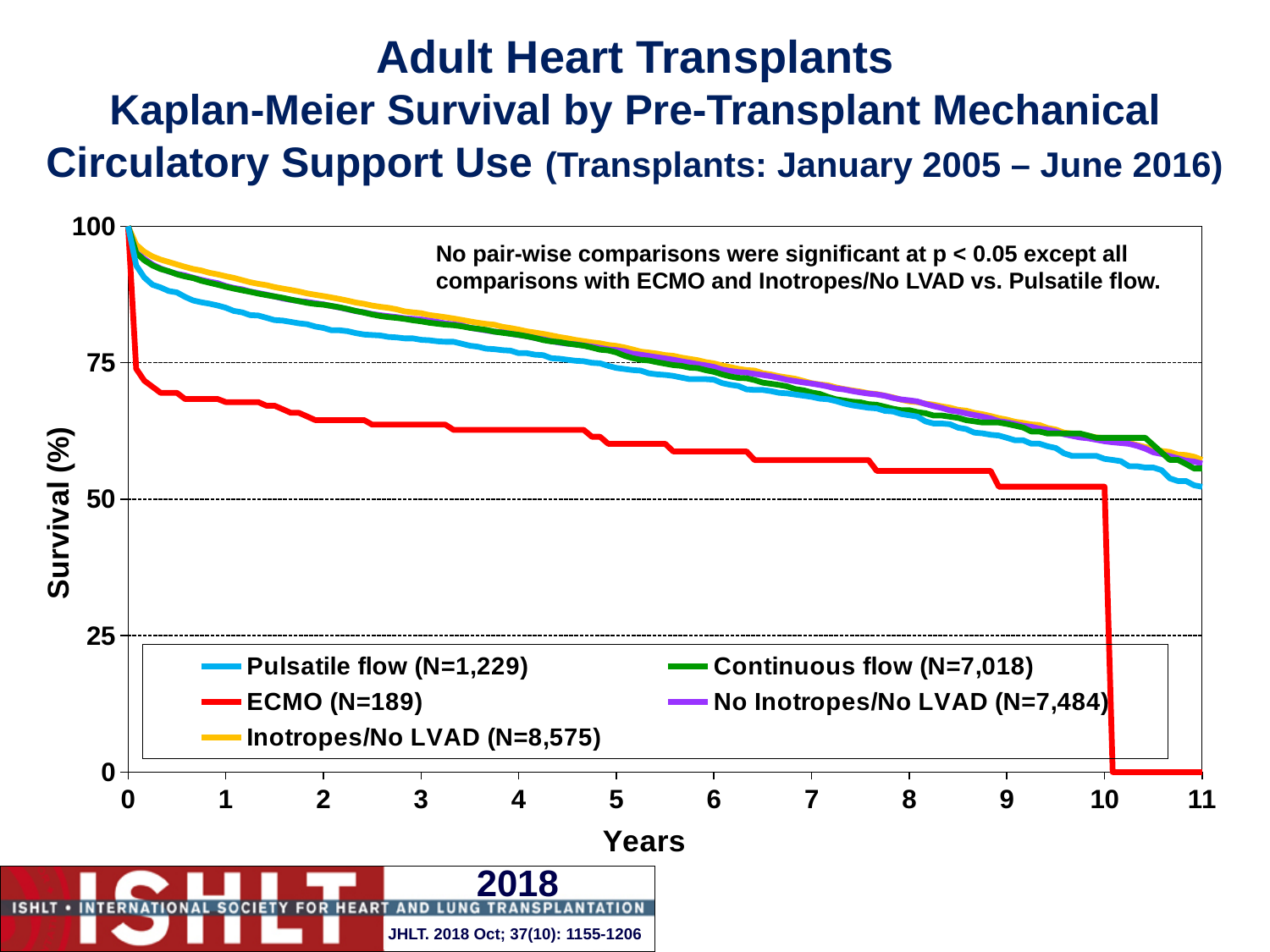
Is the survival for ECMO at 5 years greater or less than 50? greater Is the survival for ECMO at 5 years greater or less than 75? less Is the survival for Continuous flow at 10 years greater or less than 75? less What is the N for the ECMO group shown in the legend? 189 Do the survival curves rise or fall as years increase? fall What is the label of the y axis? Survival (%) What kind of chart is shown on the slide? line chart How many series does the legend list? 5 At 3 years, which has higher survival: ECMO or Continuous flow? Continuous flow What is the N for the Inotropes/No LVAD group shown in the legend? 8,575 Which series has the lowest survival at 5 years? ECMO